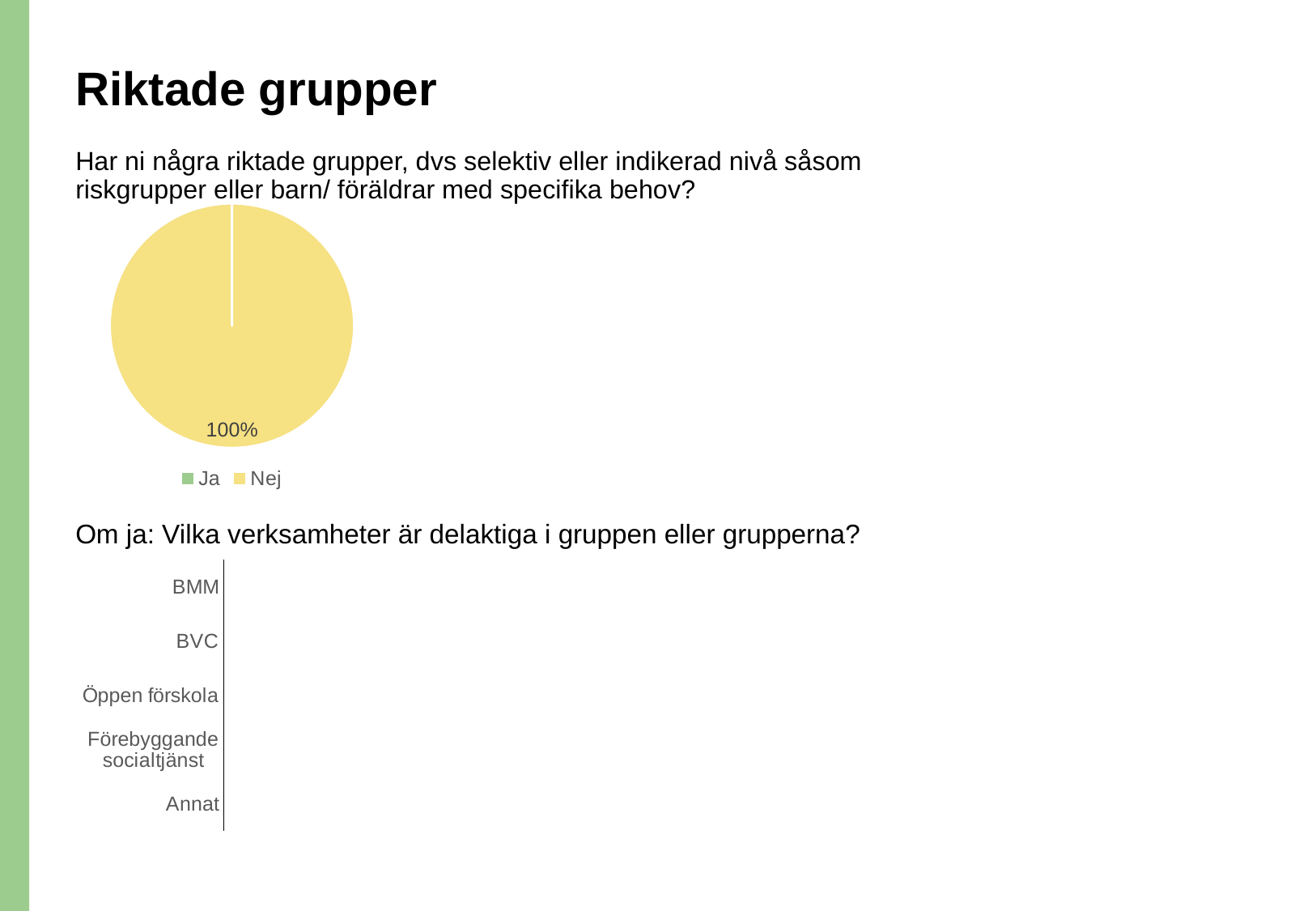
In the pie chart, what share of the pie does the Nej slice take? 100% In the pie chart, which category makes up the whole pie? Nej What colour is the Nej slice in the pie chart? yellow How many categories are listed on the axis of the lower chart, under the question 'Om ja: Vilka verksamheter är delaktiga i gruppen eller grupperna?'? 5 In the pie chart, is the share for Nej greater or less than 50%? greater What are the two legend entries of the pie chart? Ja and Nej Which category is listed last (at the bottom) on the axis of the lower bar chart? Annat What kind of chart is the lower chart on the slide, with the categories BMM, BVC, Öppen förskola, Förebyggande socialtjänst and Annat? bar chart How many entries does the legend of the pie chart list? 2 What kind of chart is the upper chart on the slide, below the question about riktade grupper? pie chart